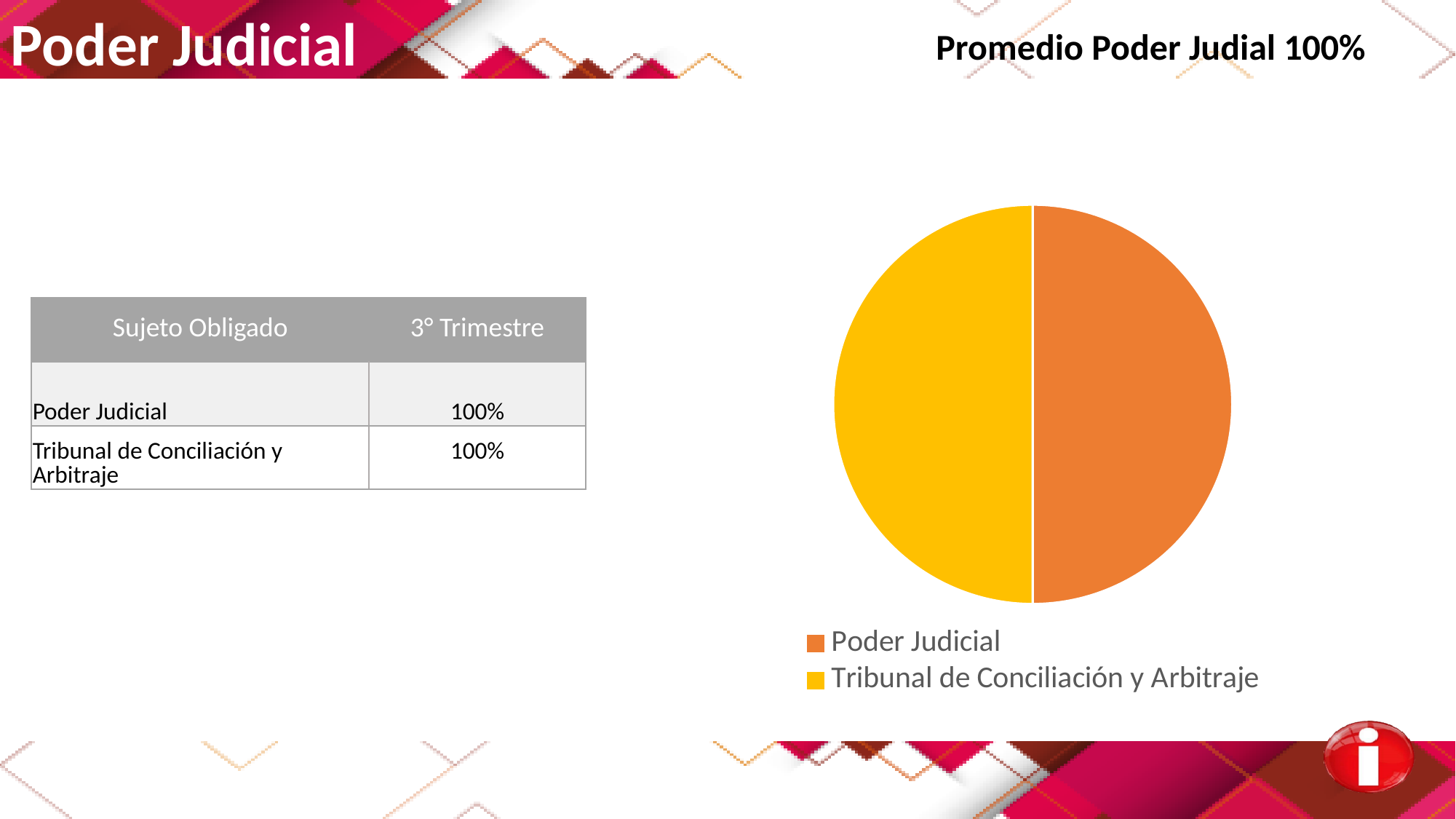
What is the difference between the table values for Poder Judicial and Tribunal de Conciliación y Arbitraje? 0% How many slices does the pie chart have? 2 Which colour represents Tribunal de Conciliación y Arbitraje in the pie chart? yellow Which colour represents Poder Judicial in the pie chart? orange How many entries does the legend of the pie chart list? 2 What share of the pie does the Poder Judicial slice take up? 50% What kind of chart is shown on the slide? pie chart According to the table, what is the 3° Trimestre value for Tribunal de Conciliación y Arbitraje? 100% According to the table, what is the 3° Trimestre value for Poder Judicial? 100% What share of the pie does the Tribunal de Conciliación y Arbitraje slice take up? 50%